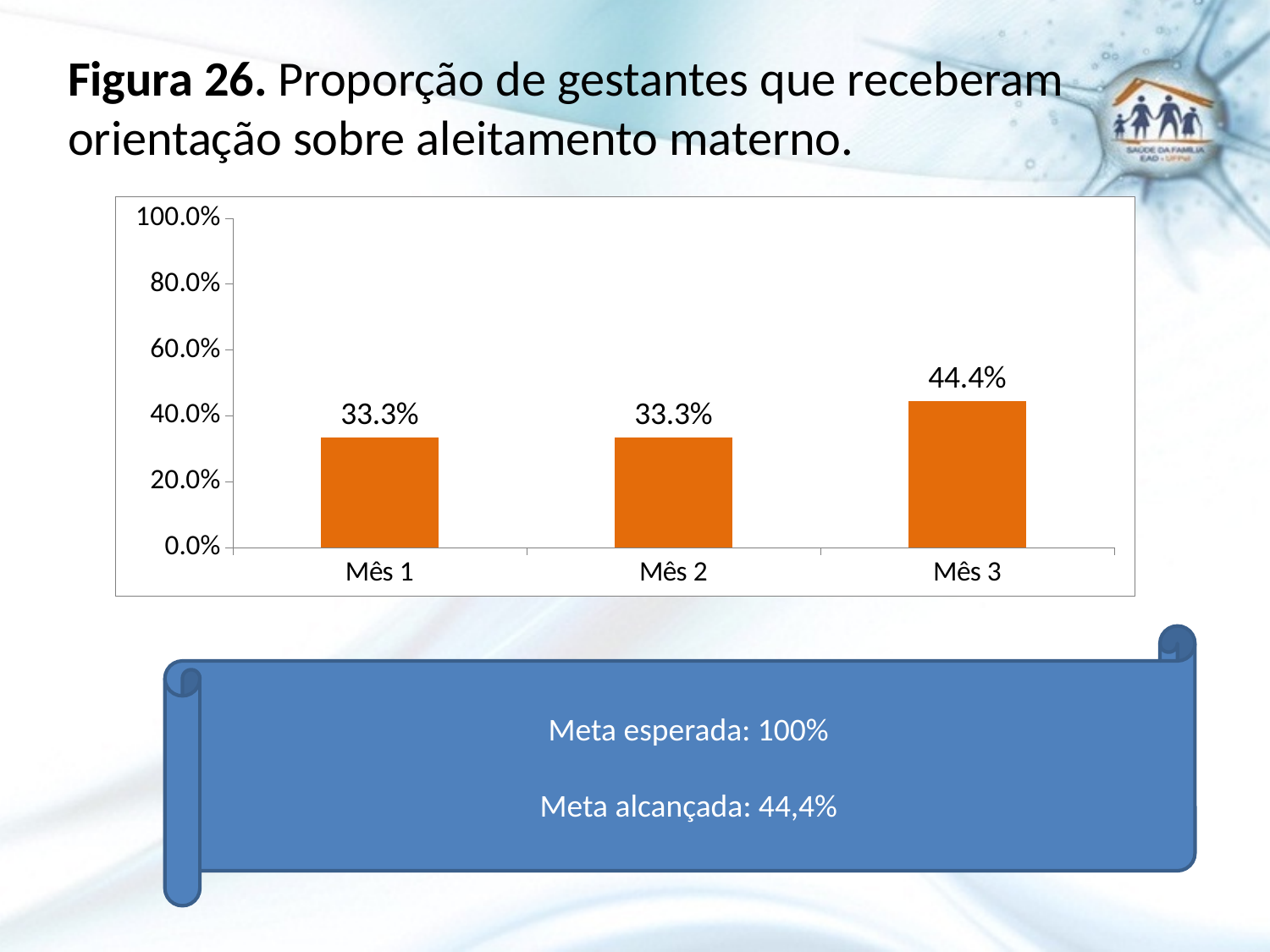
Which is larger, the value for Mês 1 or the value for Mês 3? Mês 3 Do the values rise or fall from Mês 2 to Mês 3? rise Which month has the highest value? Mês 3 Is the value for Mês 3 greater or less than 40.0%? greater What kind of chart is shown on the slide? bar chart How many months are shown on the x axis? 3 What is the value for Mês 1? 33.3% Is the value for Mês 2 greater or less than 40.0%? less What colour are the bars in the chart? orange What is the value for Mês 3? 44.4% Are the values for Mês 1 and Mês 2 the same or different? the same What is the difference between the values for Mês 3 and Mês 2? 11.1%